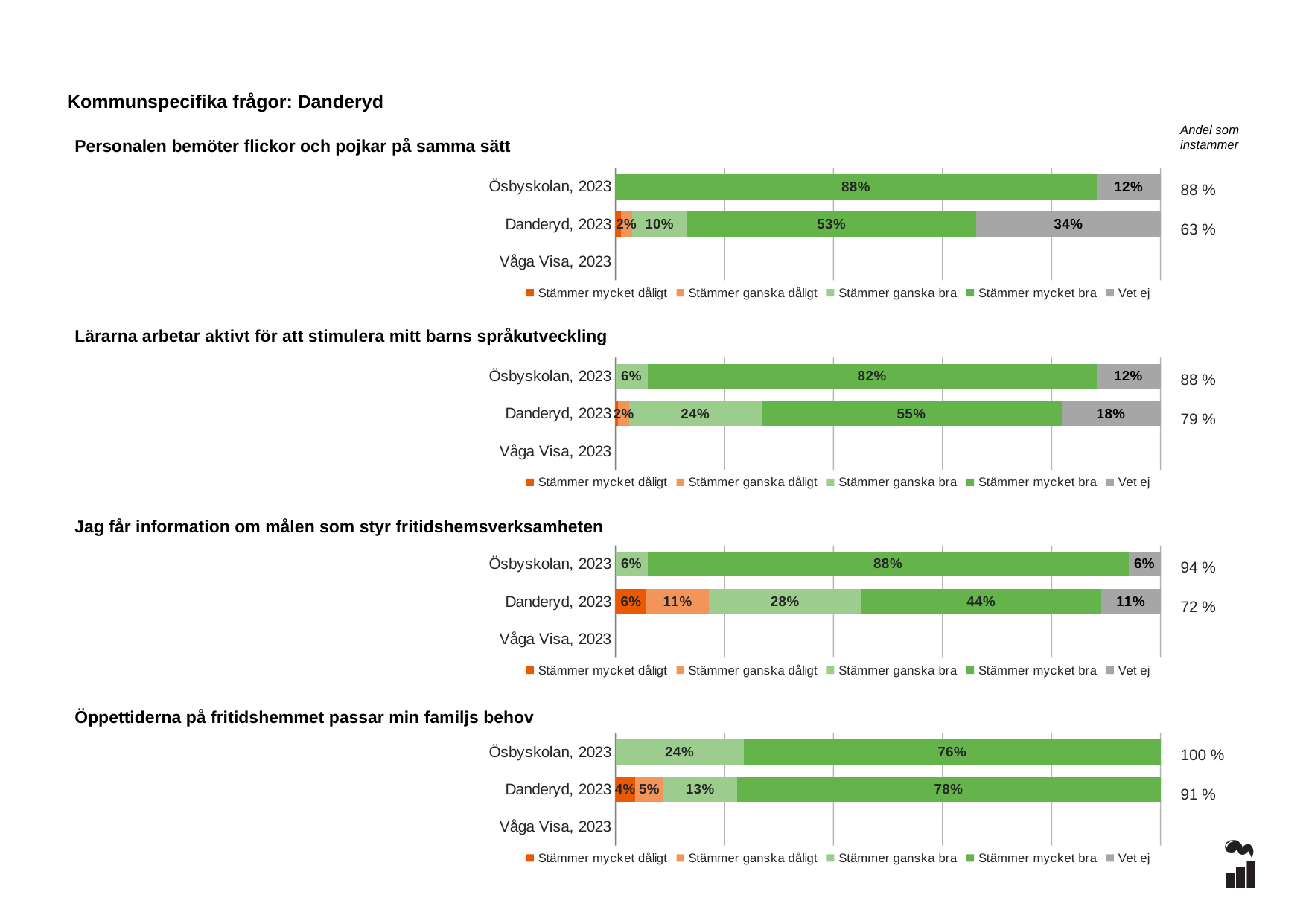
In the chart 'Jag får information om målen som styr fritidshemsverksamheten', which has the larger 'Stämmer mycket bra' value, Ösbyskolan, 2023 or Danderyd, 2023? Ösbyskolan, 2023 In the chart 'Lärarna arbetar aktivt för att stimulera mitt barns språkutveckling', what is the 'Stämmer ganska bra' value for Danderyd, 2023? 24% In the chart 'Öppettiderna på fritidshemmet passar min familjs behov', what is the total of the Ösbyskolan, 2023 stacked bar? 100% In the chart 'Öppettiderna på fritidshemmet passar min familjs behov', what is the 'Stämmer mycket bra' value for Danderyd, 2023? 78% In the chart 'Öppettiderna på fritidshemmet passar min familjs behov', what is the 'Stämmer ganska bra' value for Ösbyskolan, 2023? 24% How many series does the legend of the chart 'Personalen bemöter flickor och pojkar på samma sätt' list? 5 In the chart 'Personalen bemöter flickor och pojkar på samma sätt', what is the 'Vet ej' value for Danderyd, 2023? 34% In the chart 'Lärarna arbetar aktivt för att stimulera mitt barns språkutveckling', what is the difference between the 'Stämmer mycket bra' values for Ösbyskolan, 2023 and Danderyd, 2023? 27% What kind of chart is 'Jag får information om målen som styr fritidshemsverksamheten'? Stacked bar chart In the chart 'Jag får information om målen som styr fritidshemsverksamheten', what is the 'Stämmer mycket dåligt' value for Danderyd, 2023? 6% In the chart 'Personalen bemöter flickor och pojkar på samma sätt', what is the 'Stämmer mycket bra' value for Ösbyskolan, 2023? 88% How many categories are shown on the y axis of the chart 'Lärarna arbetar aktivt för att stimulera mitt barns språkutveckling'? 3